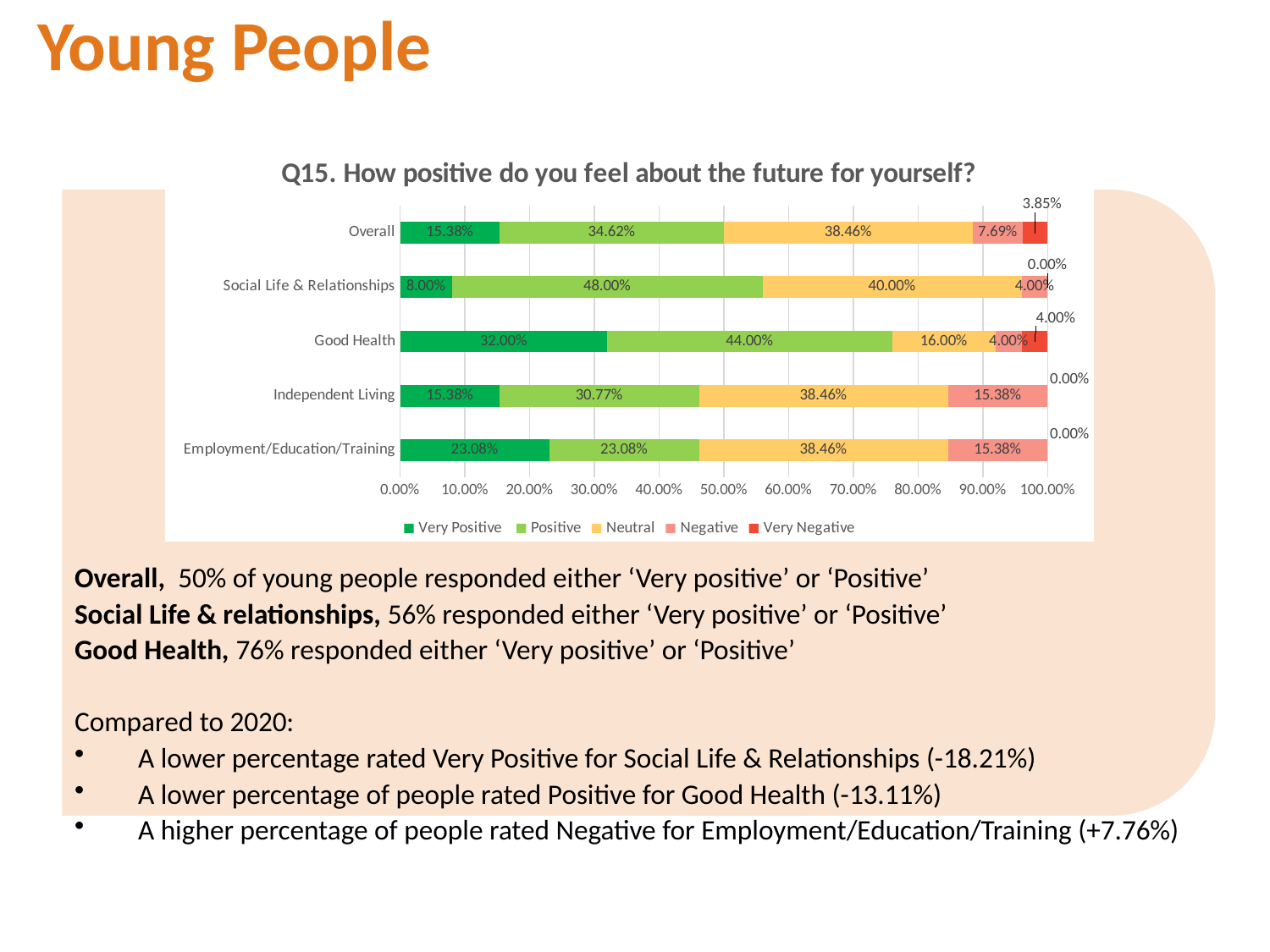
Which is larger, the Neutral value for Social Life & Relationships or the Neutral value for Good Health? Social Life & Relationships What is the difference between the Positive values for Good Health and Employment/Education/Training? 20.92% What type of chart is shown on the slide? Stacked bar chart What is the Negative value for Independent Living? 15.38% How many series does the legend list? 5 Which category has the lowest Very Positive value? Social Life & Relationships Which category has the highest Very Positive value? Good Health What is the Very Negative value for Overall? 3.85% What is the Positive value for Social Life & Relationships? 48.00% What is the Very Positive value for Good Health? 32.00% How many categories are shown on the chart? 5 What is the Neutral value for Overall? 38.46%